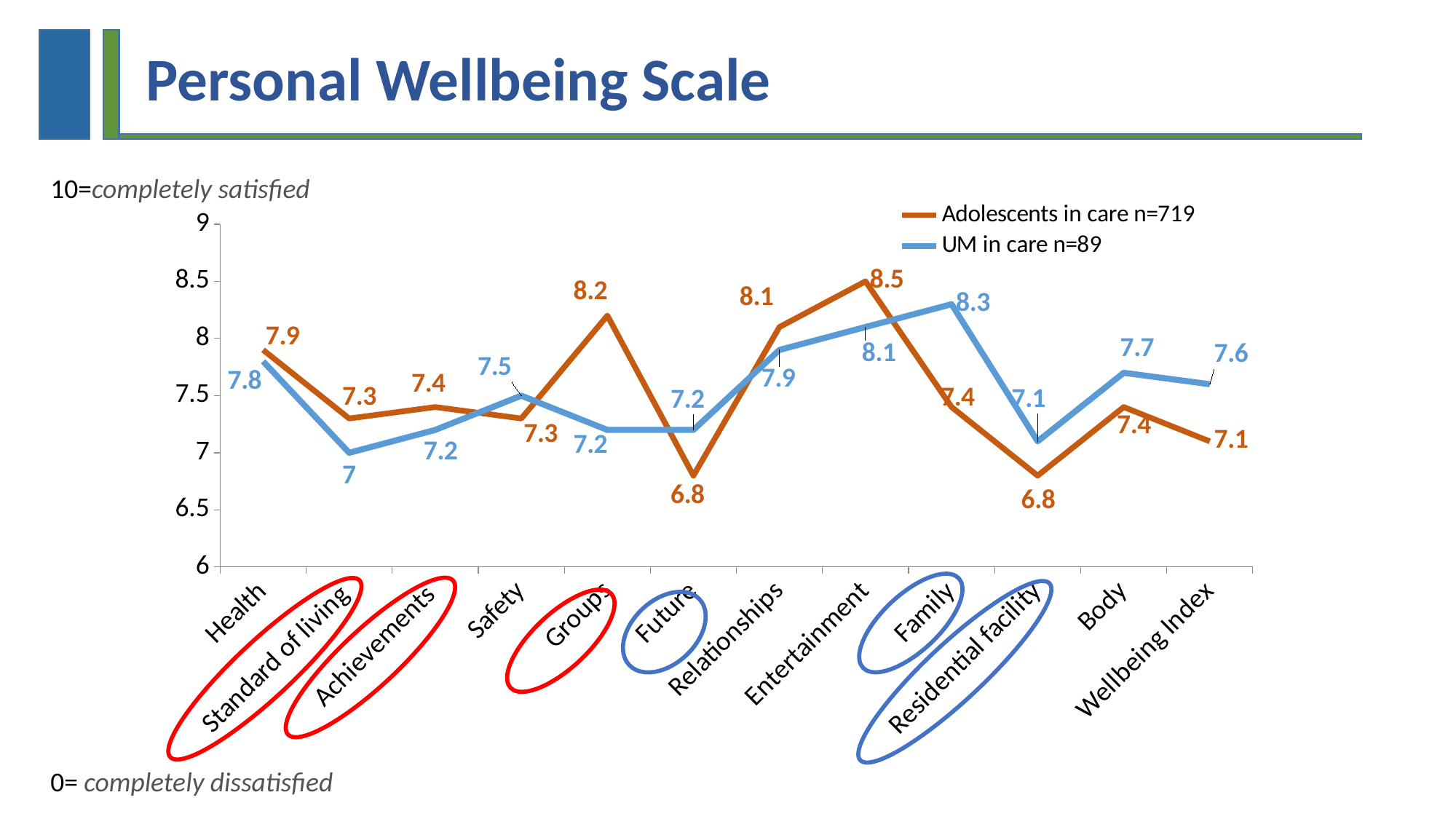
How many categories are shown on the x axis? 12 Which category has the highest value for Adolescents in care? Entertainment For Body, which series has the larger value, Adolescents in care or UM in care? UM in care What is the difference between Adolescents in care and UM in care for Groups? 1 What is the difference between Adolescents in care and UM in care for Entertainment? 0.4 Which category has the highest value for UM in care? Family What is the value for UM in care for Family? 8.3 What kind of chart is shown on the slide? Line chart How many series does the legend list? 2 Which category has the lowest value for UM in care? Standard of living What is the value for Adolescents in care for Wellbeing Index? 7.1 What is the value for Adolescents in care for Groups? 8.2